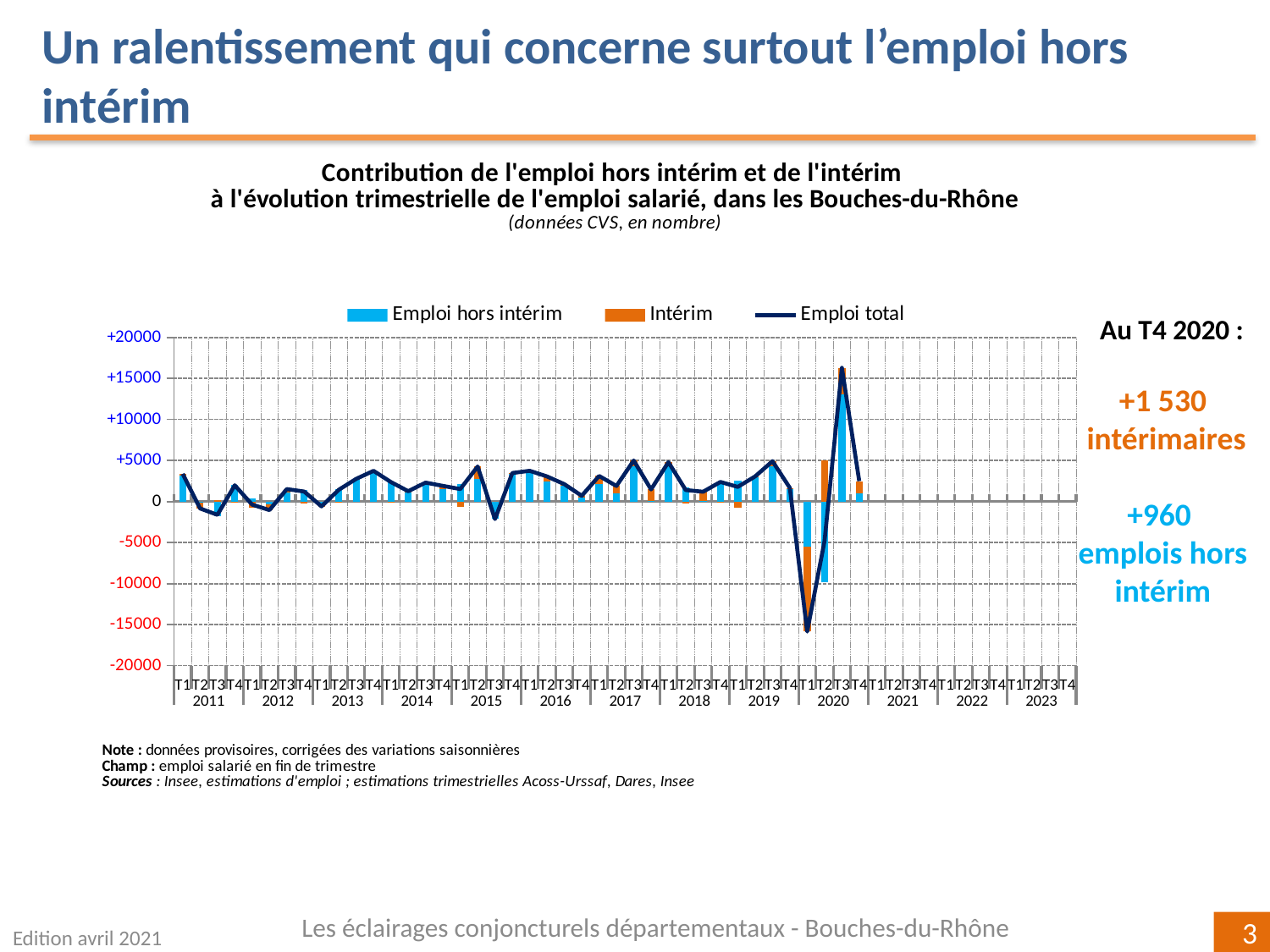
What is the difference between the Intérim (+1 530) and Emploi hors intérim (+960) contributions at T4 2020? 570 What kind of chart is shown on the slide? A combined bar and line chart According to the slide, what is the contribution of Emploi hors intérim at T4 2020? +960 In which quarter does the Emploi total line reach its lowest point? T1 2020 How many series does the chart legend list? 3 Is the Emploi hors intérim bar at T2 2020 greater or less than -5000? less Is the value of Emploi total at T2 2020 greater or less than -10000? greater Which colour represents the Intérim series in the chart? Orange At T4 2020, which is larger: the Intérim contribution or the Emploi hors intérim contribution? Intérim In which quarter does the Emploi total line reach its highest point? T3 2020 Is the value of Emploi total at T3 2020 greater or less than +10000? greater According to the slide, what is the contribution of Intérim at T4 2020? +1 530